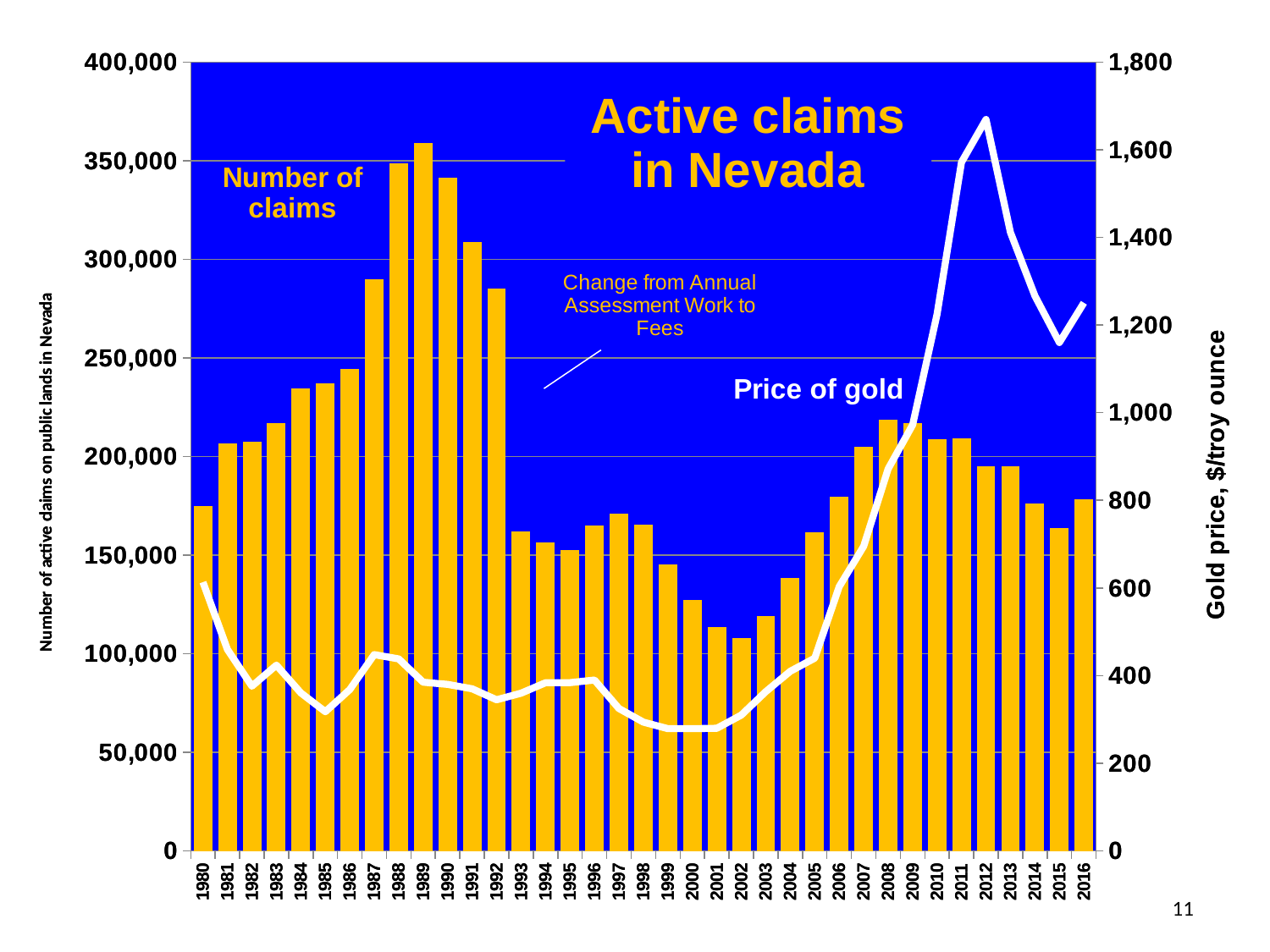
How many years (bars) are plotted on the x axis? 37 Is the number of claims in 2002 greater or less than 150,000? less What is the title of the chart? Active claims in Nevada Is the price of gold in 2012 greater or less than 1,600 $/troy ounce? greater Which year has more active claims, 1987 or 1991? 1991 In which year does the price of gold reach its peak? 2012 Is the number of claims in 1989 greater or less than 300,000? greater What kind of chart is used to show the number of claims? Bar chart Does the number of claims rise or fall from 1980 to 1989? rise What is the label of the right-hand y axis? Gold price, $/troy ounce Which year has the highest number of active claims? 1989 Which year has the lowest number of active claims? 2002